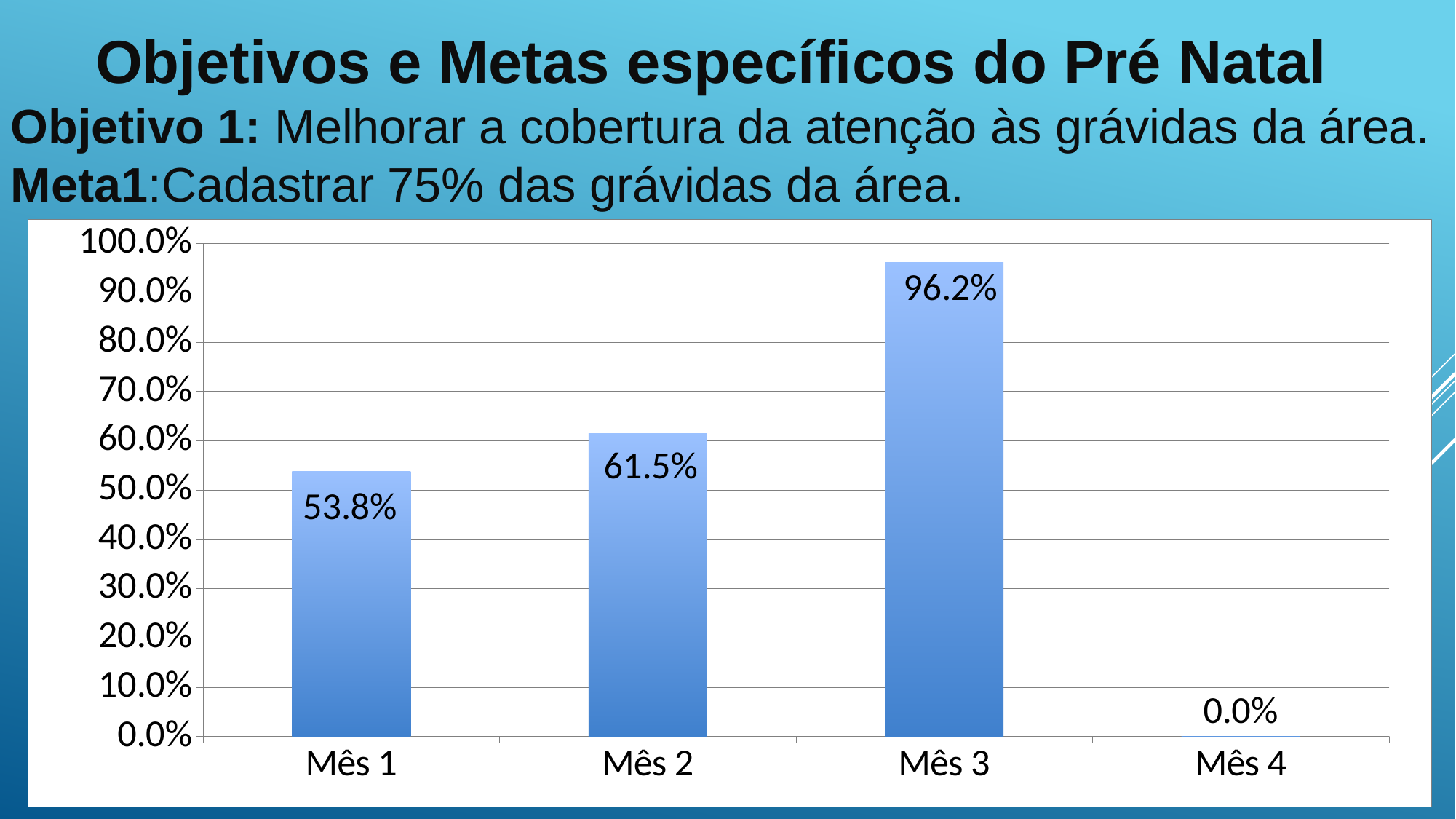
What is the value for Mês 4? 0.0% Which month has the highest value? Mês 3 What is the value for Mês 2? 61.5% Which is larger, the value for Mês 1 or the value for Mês 2? Mês 2 What kind of chart is shown on the slide? bar chart How many months are shown on the x axis? 4 Is the value for Mês 3 greater or less than 90.0%? greater What is the difference between the values for Mês 3 and Mês 2? 34.7% What is the value for Mês 1? 53.8% Which month has the lowest value? Mês 4 What is the value for Mês 3? 96.2% What is the difference between the values for Mês 2 and Mês 1? 7.7%